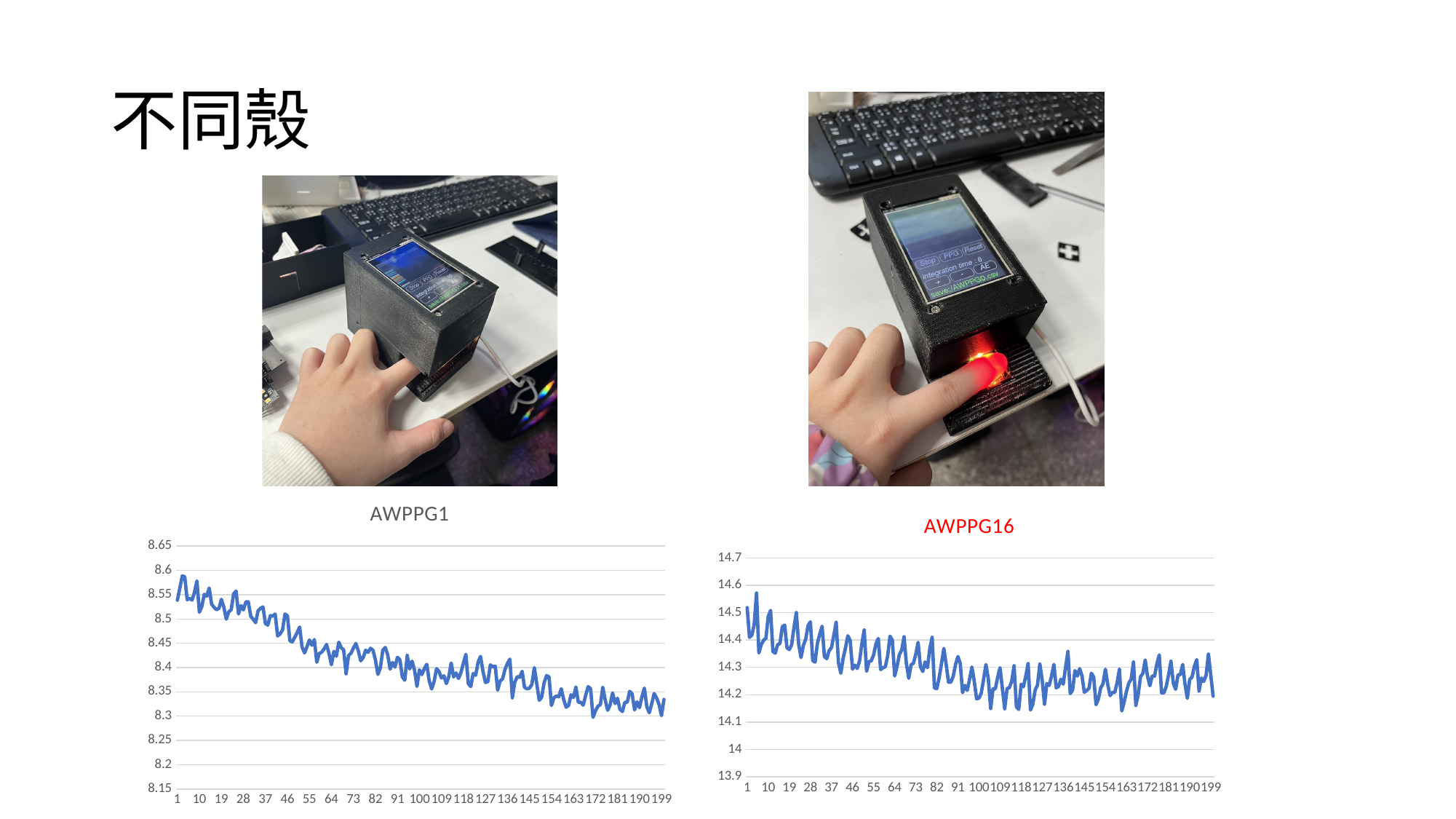
In the AWPPG16 chart, is the value at x = 199 greater or less than 14.4? less In the AWPPG1 chart, is the value at x = 1 greater or less than 8.5? greater What kind of chart is the AWPPG1 chart? line chart What is the title of the chart on the left of the slide? AWPPG1 In the AWPPG1 chart, do the values generally rise or fall along the x axis? fall What kind of chart is the AWPPG16 chart? line chart In the AWPPG16 chart, do the values generally rise or fall along the x axis? fall In the AWPPG16 chart, is the value at x = 100 greater or less than 14.5? less What is the highest y-axis tick shown on the AWPPG16 chart? 14.7